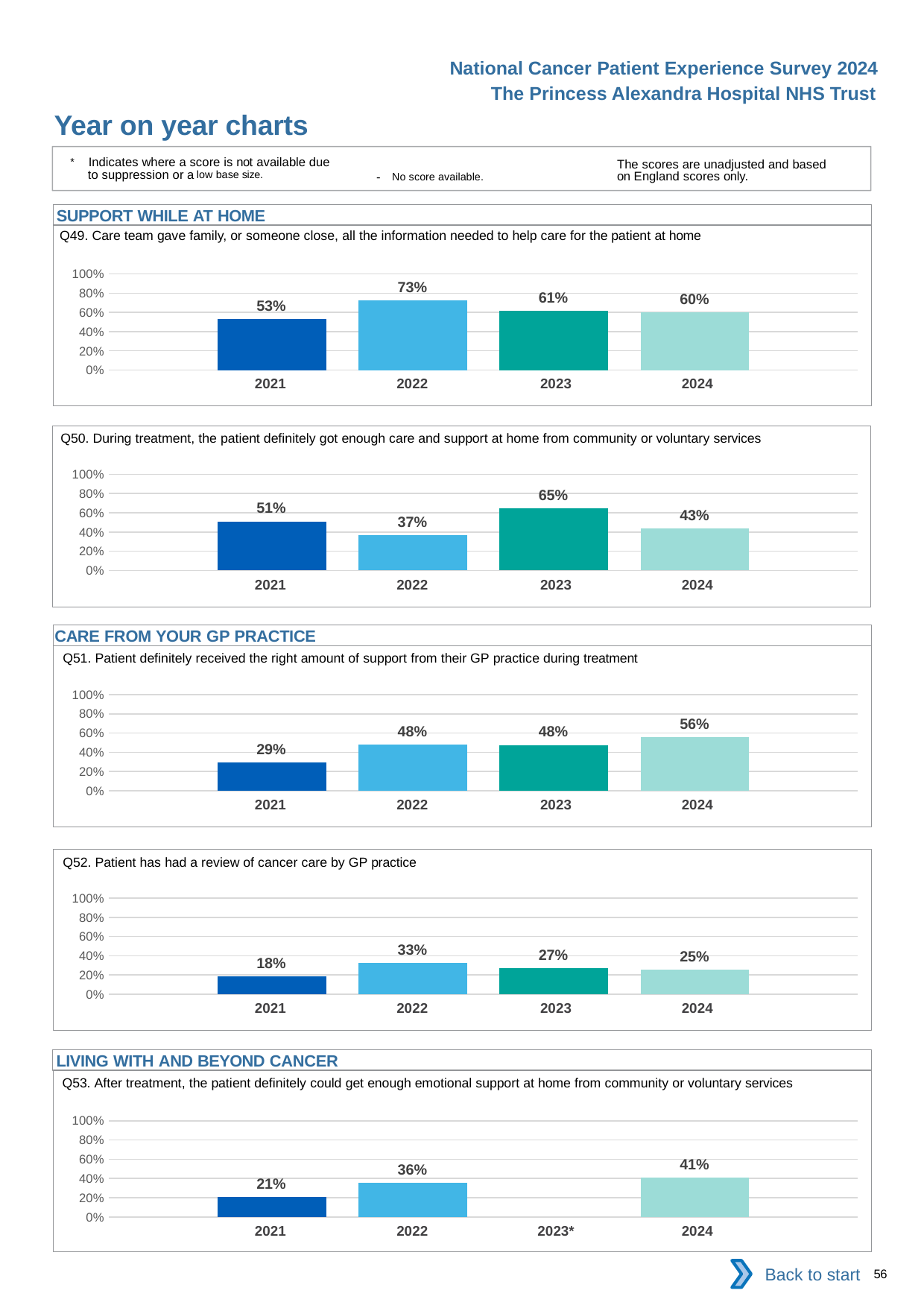
In the Q49 chart, which year has the lowest value? 2021 In the Q52 chart, which is larger, the value for 2022 or the value for 2024? 2022 In the Q51 chart, is the value for 2024 greater or less than 40%? greater In the Q49 chart, what is the value for 2022? 73% In the Q52 chart, do the values rise or fall from 2022 to 2024? Fall In the Q53 chart, which year has no bar plotted? 2023* In the Q52 chart, what is the value for 2021? 18% In the Q50 chart, which year has the highest value? 2023 In the Q53 chart, how many years are shown on the x axis? 4 In the Q51 chart, what is the value for 2021? 29% What kind of chart is the Q52 chart? Bar chart In the Q50 chart, what is the difference between the 2023 and 2022 values? 28%